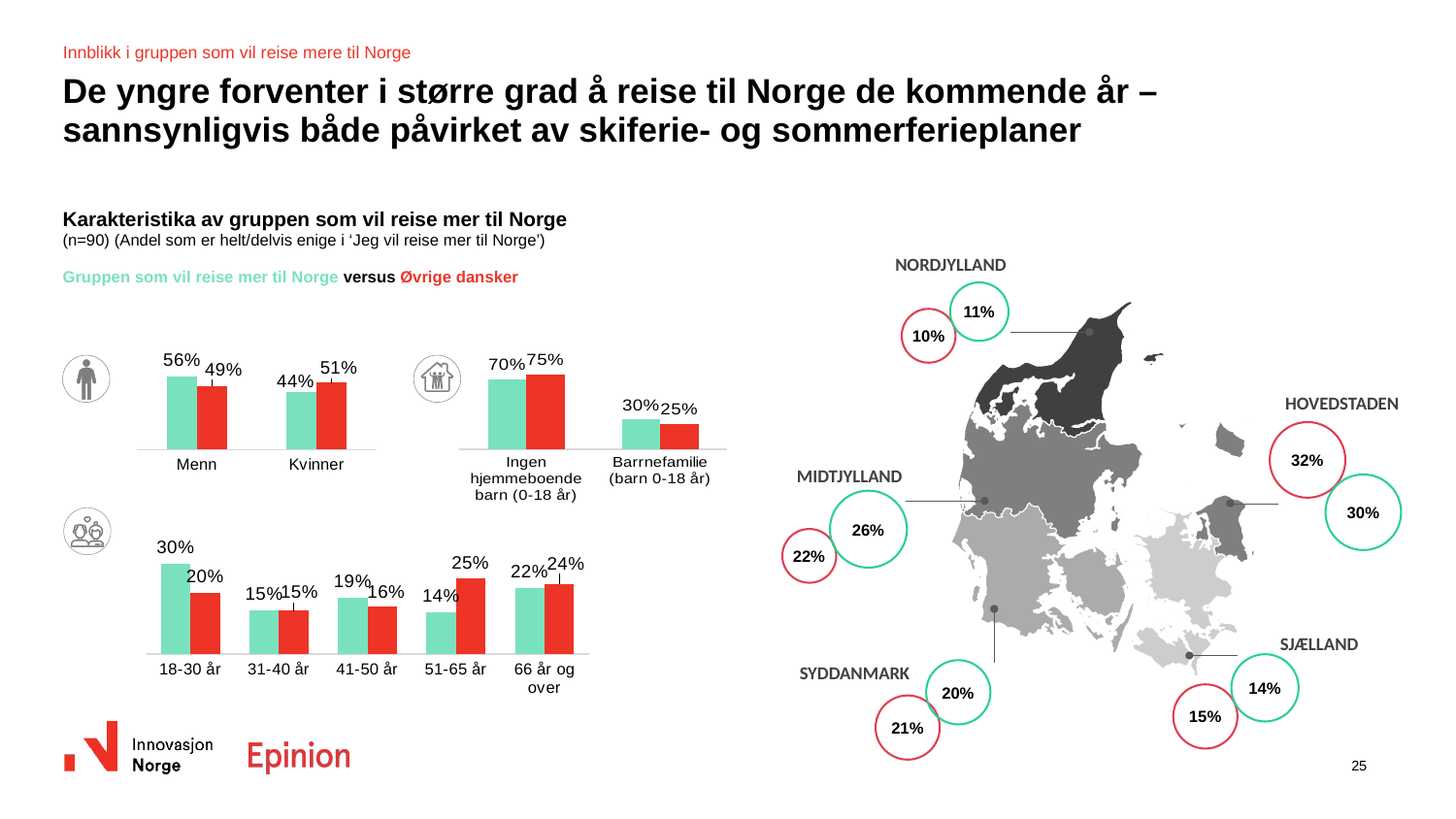
What type of chart is used to show the characteristics of the group that wants to travel more to Norway? Bar chart In the age bar chart (bottom left), which age group has the highest value for the group that wants to travel more to Norway (green bars)? 18-30 år In the age bar chart (bottom left), what is the difference between the two values shown for 18-30 år? 10 percentage points In the gender bar chart (top left), what is the value for Kvinner among Øvrige dansker (red bars)? 51% In the gender bar chart (top left), what is the value for Menn in the group that wants to travel more to Norway (green bars)? 56% In the age bar chart (bottom left), what is the value for 51-65 år among Øvrige dansker (red bars)? 25% In the age bar chart (bottom left), which is larger for 41-50 år: the green bar or the red bar? The green bar (19%) In the age bar chart (bottom left), which age group has the lowest value for the group that wants to travel more to Norway (green bars)? 51-65 år In the children bar chart (top middle), what is the value for Barnefamilie (barn 0-18 år) in the group that wants to travel more to Norway (green bars)? 30% In the children bar chart (top middle), what is the value for Ingen hjemmeboende barn among Øvrige dansker (red bars)? 75% In the gender bar chart (top left), what is the difference between the two values shown for Menn? 7 percentage points How many age groups are shown in the age bar chart (bottom left)? 5